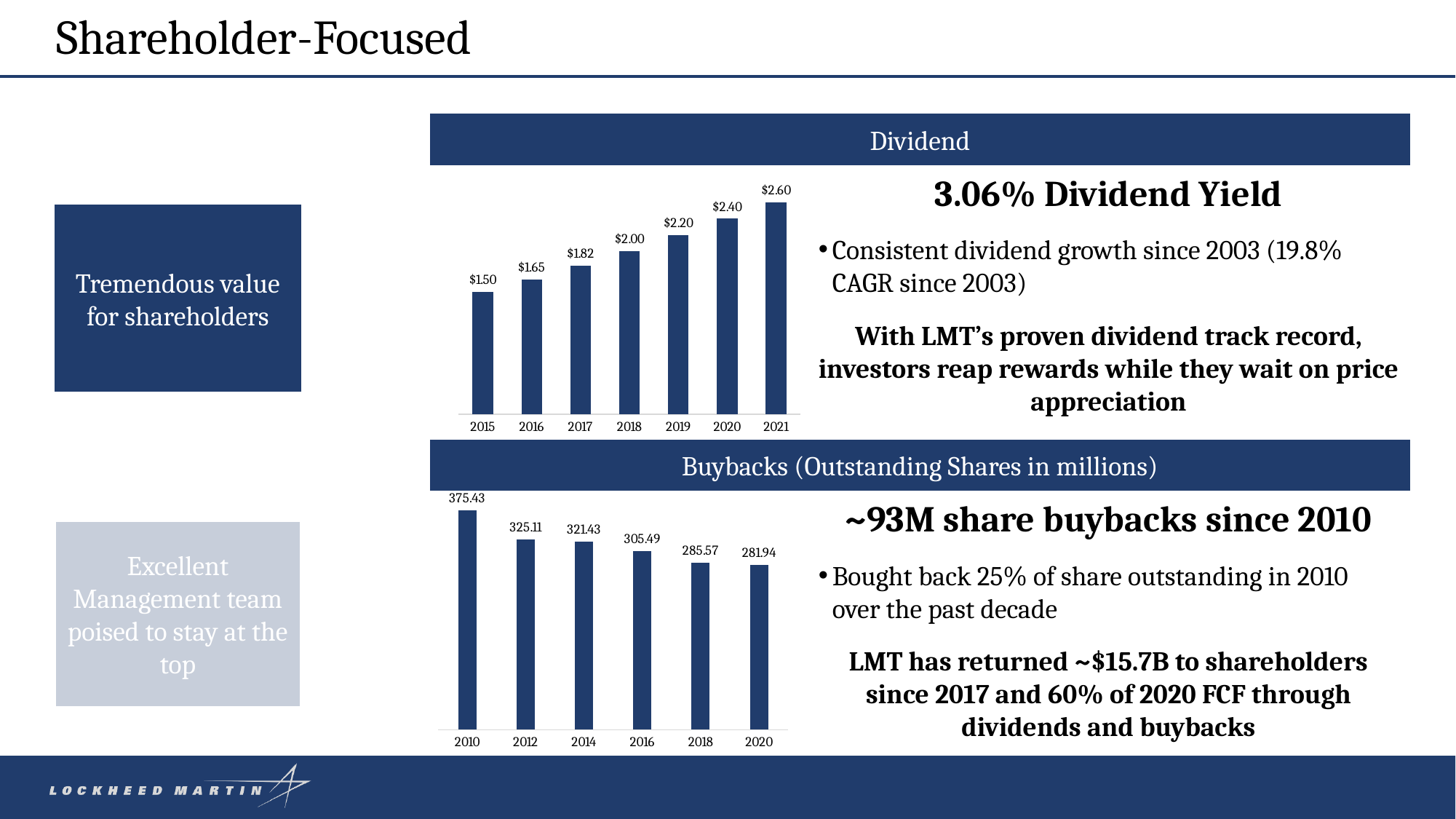
In the Dividend chart, how many years are shown? 7 In the Buybacks (Outstanding Shares in millions) chart, what is the difference between the 2010 and 2020 values? 93.49 In the Dividend chart, which year has the lowest value? 2015 In the Dividend chart, what is the value for 2017? $1.82 In the Buybacks (Outstanding Shares in millions) chart, how many years are shown? 6 In the Buybacks (Outstanding Shares in millions) chart, which is larger, the value for 2012 or the value for 2016? 2012 In the Dividend chart, what is the value for 2021? $2.60 In the Buybacks (Outstanding Shares in millions) chart, which year has the highest value? 2010 In the Buybacks (Outstanding Shares in millions) chart, what is the value for 2014? 321.43 What kind of chart is the Buybacks (Outstanding Shares in millions) chart? bar chart In the Dividend chart, do the values rise or fall from 2015 to 2021? rise In the Dividend chart, what is the difference between the 2021 and 2015 values? $1.10